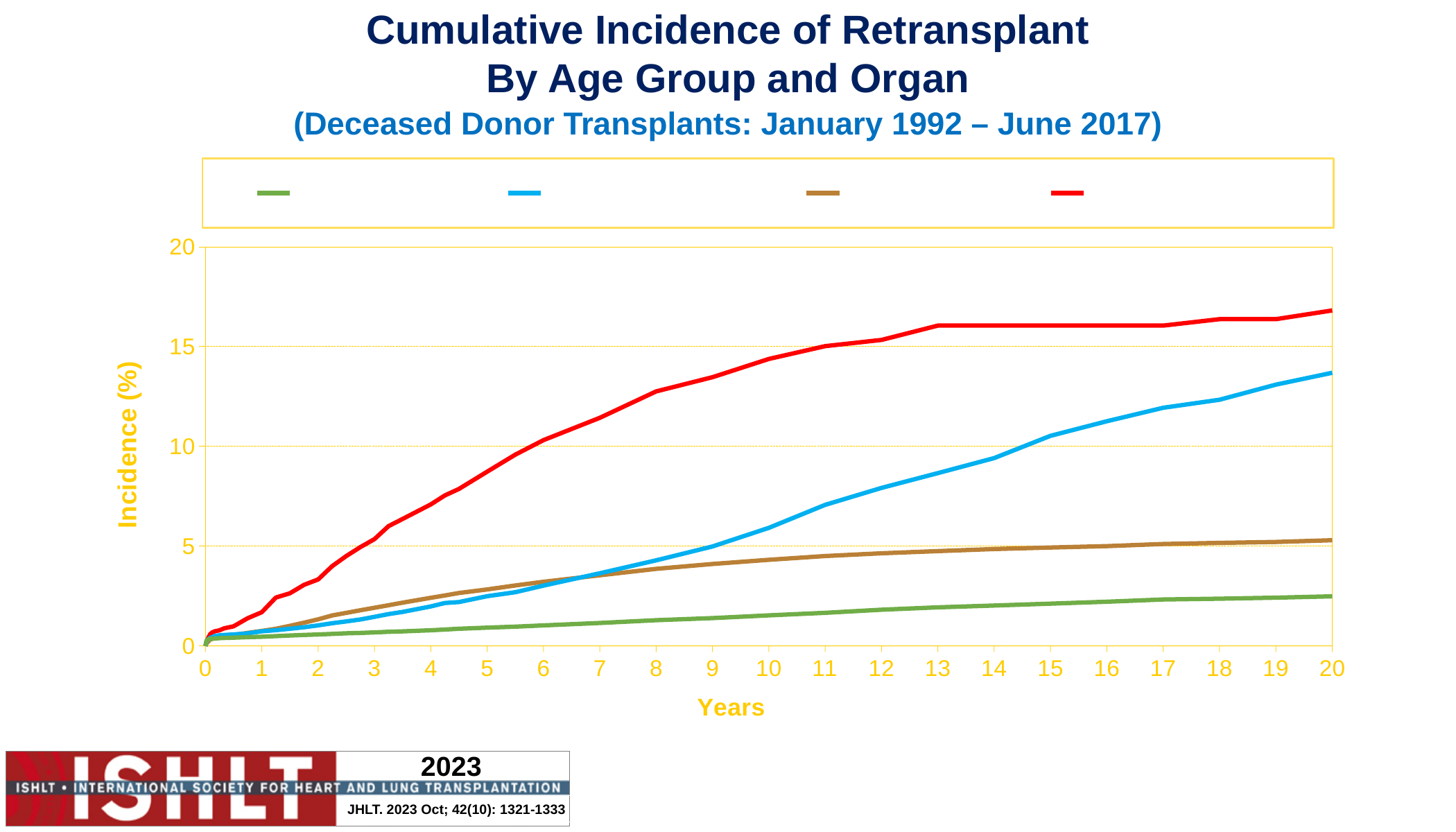
Is the value of the green line at 20 years greater or less than 5? less Is the value of the blue line at 20 years greater or less than 10? greater Is the value of the red line at 5 years greater or less than 5? greater How many series does the legend list? 4 Which coloured line has the lowest incidence at 20 years? green Which coloured line has the highest incidence at 20 years? red What is the label of the y axis? Incidence (%) Do the values of the red line rise or fall as the years increase? rise What kind of chart is shown on the slide? line chart At 10 years, which line is higher, the blue line or the brown line? blue